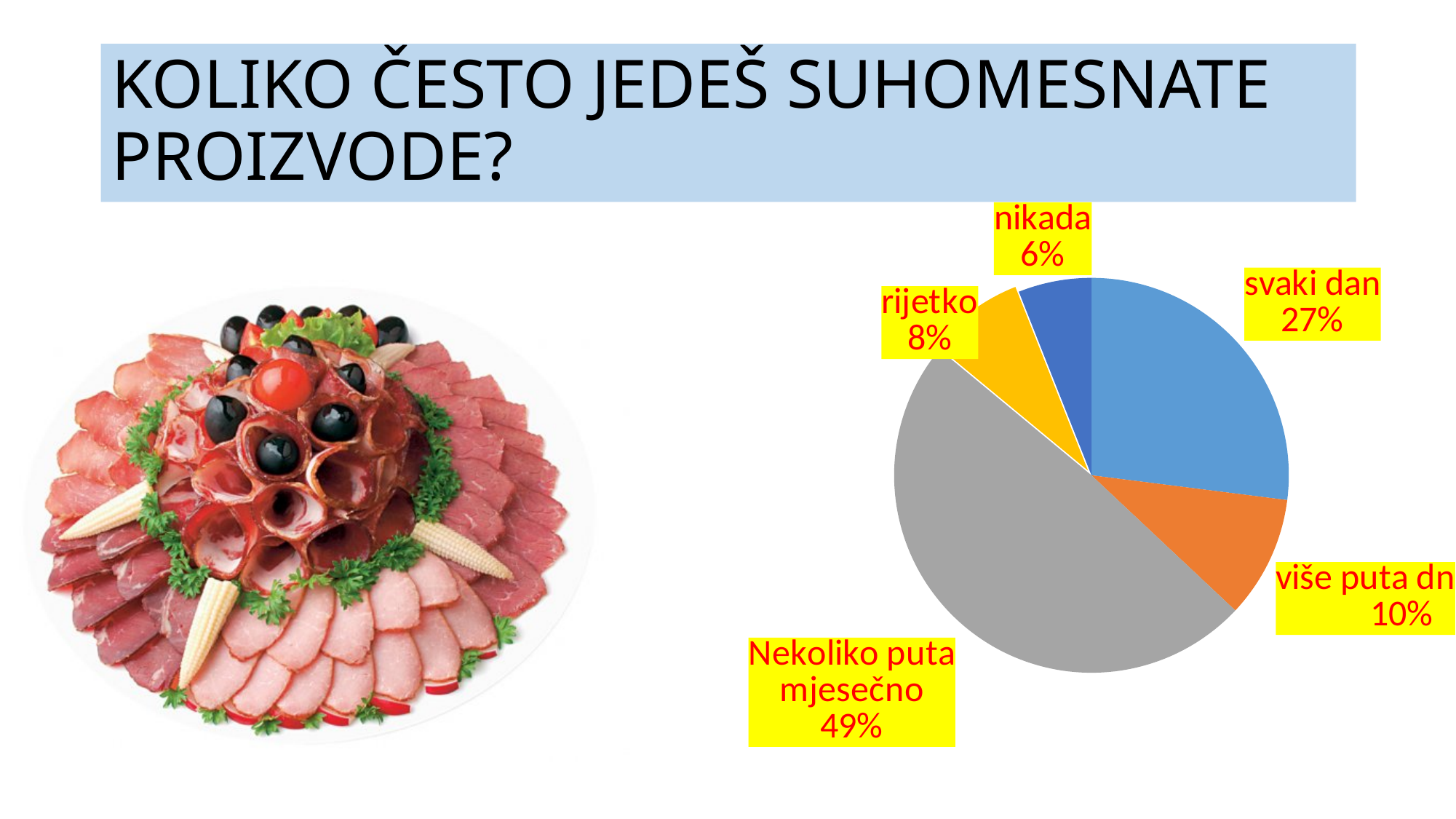
What percentage is shown for "nikada"? 6% What kind of chart is shown on the slide? pie chart What is the difference in percentage points between "rijetko" and "nikada"? 2 What colour is the slice for "Nekoliko puta mjesečno"? grey What is the difference in percentage points between "Nekoliko puta mjesečno" and "svaki dan"? 22 What percentage is shown for "svaki dan"? 27% How many slices does the pie chart have? 5 What share of the pie does "Nekoliko puta mjesečno" represent? 49% Which category has the largest slice of the pie? Nekoliko puta mjesečno Which category has the smallest slice of the pie? nikada Which is larger, the slice for "svaki dan" or the slice for "rijetko"? svaki dan What percentage is shown for "rijetko"? 8%